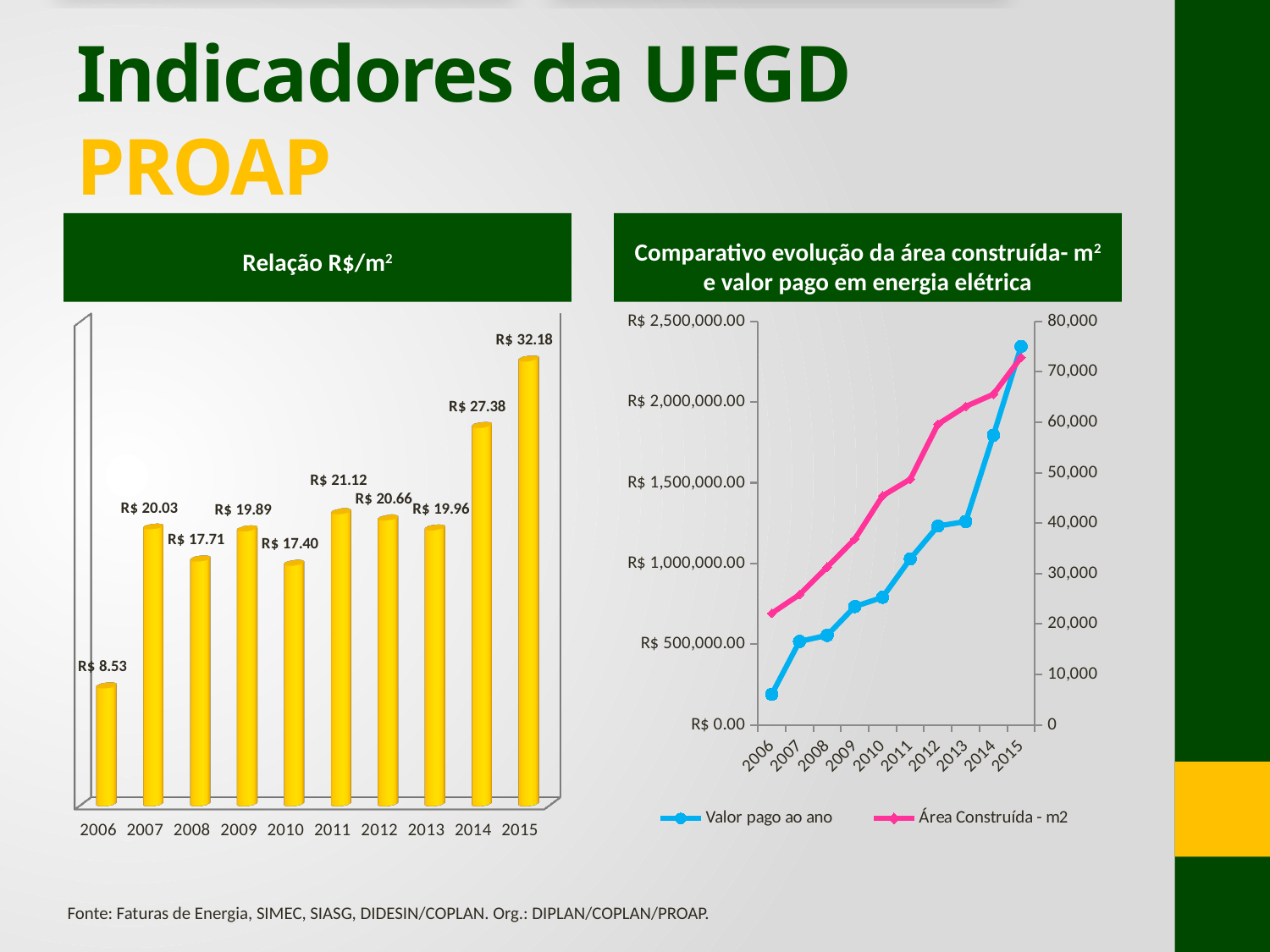
In the 'Relação R$/m²' chart, which is larger, the value for 2011 or the value for 2008? 2011 How many years are shown in the 'Relação R$/m²' chart? 10 In the 'Relação R$/m²' chart, what is the difference between the 2015 and 2014 values? R$ 4.80 In the 'Comparativo evolução da área construída' chart, does the 'Área Construída - m2' series rise or fall from 2006 to 2015? Rise In the 'Comparativo evolução da área construída' chart, is the 'Valor pago ao ano' value for 2015 greater or less than R$ 2,000,000.00? greater How many series does the legend of the 'Comparativo evolução da área construída' chart list? 2 In the 'Relação R$/m²' chart, what is the value for 2006? R$ 8.53 In the 'Relação R$/m²' chart, which year has the highest value? 2015 What kind of chart is the 'Relação R$/m²' chart? Bar chart In the 'Relação R$/m²' chart, which year has the lowest value? 2006 In the 'Relação R$/m²' chart, what is the value for 2015? R$ 32.18 In the 'Relação R$/m²' chart, what is the value for 2010? R$ 17.40